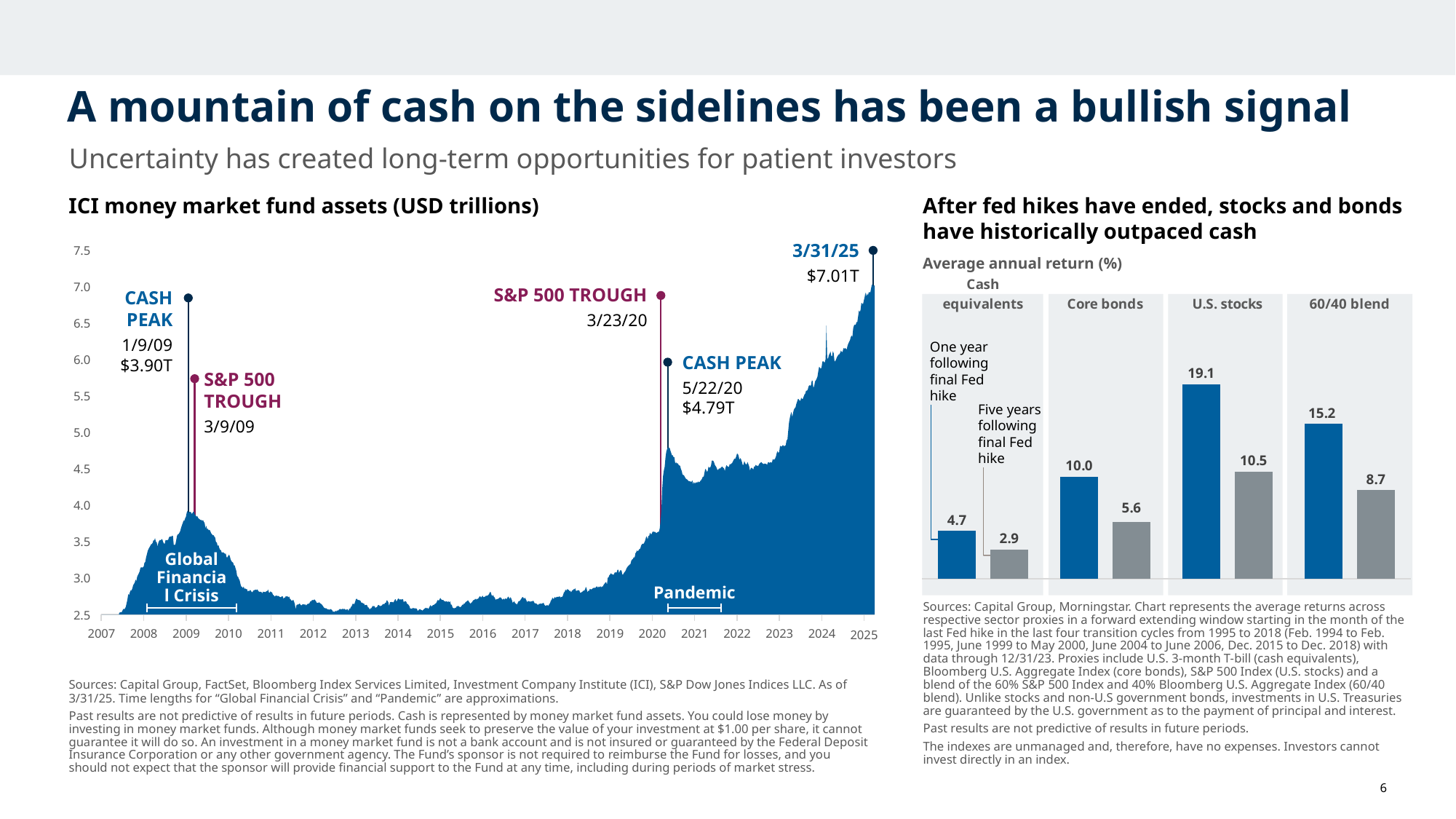
In the 'Average annual return (%)' chart, what is the five-year return following the final Fed hike for cash equivalents? 2.9 In the 'Average annual return (%)' chart, what is the difference between the one-year and five-year returns for the 60/40 blend? 6.5 In the 'Average annual return (%)' chart, which asset class has the highest one-year return following the final Fed hike? U.S. stocks In the 'Average annual return (%)' chart, what is the one-year return following the final Fed hike for U.S. stocks? 19.1 In the 'ICI money market fund assets' chart, what kind of chart is shown? Area chart In the 'ICI money market fund assets' chart, what was the value on 3/31/25? $7.01T In the 'ICI money market fund assets' chart, what was the value at the cash peak on 5/22/20? $4.79T In the 'Average annual return (%)' chart, which asset class has the lowest five-year return following the final Fed hike? Cash equivalents In the 'ICI money market fund assets' chart, what was the value at the cash peak on 1/9/09? $3.90T In the 'ICI money market fund assets' chart, what is the difference between the 3/31/25 value and the 5/22/20 cash peak? $2.22T In the 'Average annual return (%)' chart, how many asset classes are shown? 4 In the 'ICI money market fund assets' chart, is the value in 2015 greater or less than 3.5? less